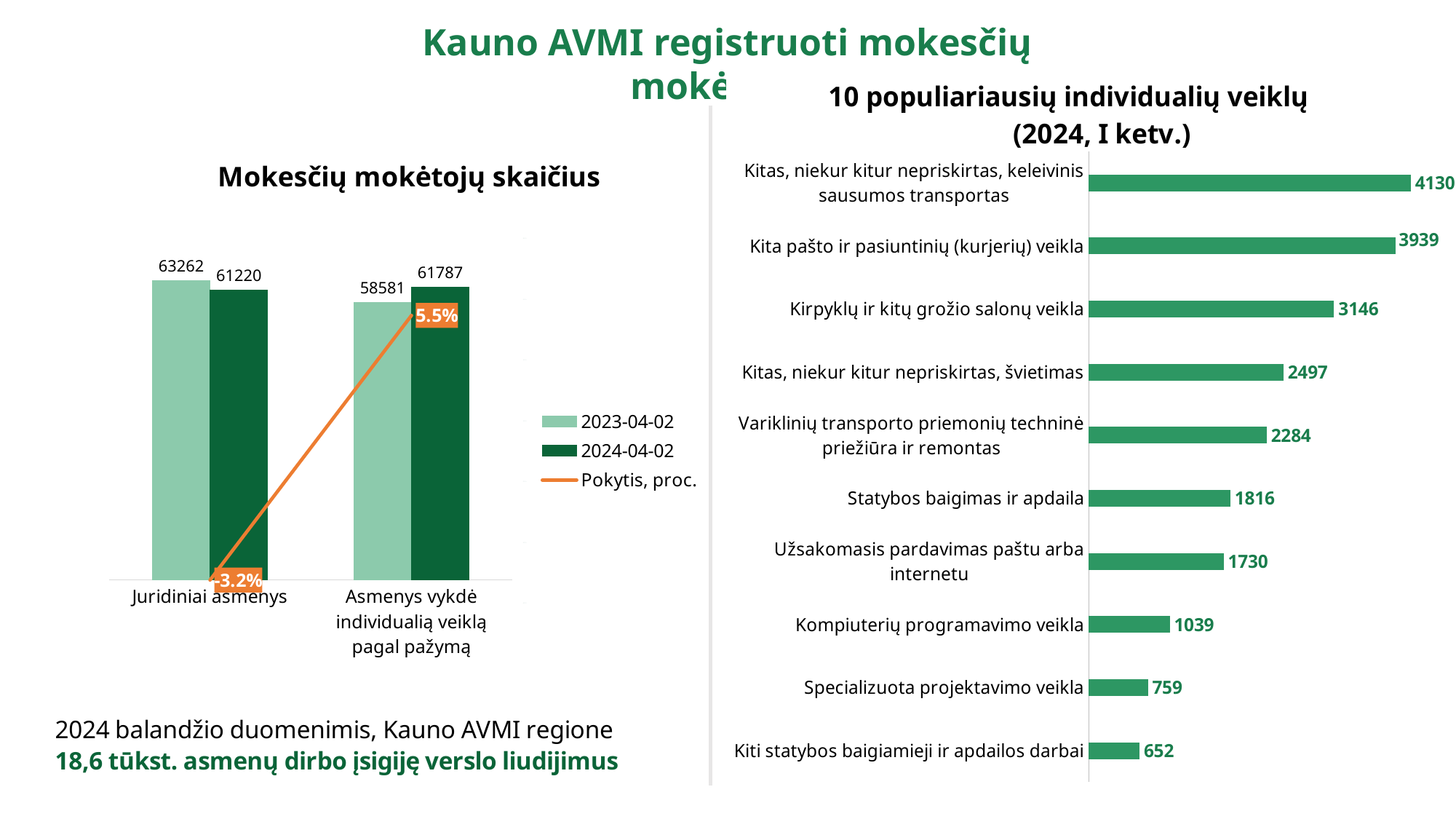
In the chart 'Mokesčių mokėtojų skaičius', what is the value for Juridiniai asmenys in the 2023-04-02 series? 63262 What kind of chart is '10 populiariausių individualių veiklų (2024, I ketv.)'? Bar chart How many categories are shown in the chart '10 populiariausių individualių veiklų (2024, I ketv.)'? 10 In the chart '10 populiariausių individualių veiklų (2024, I ketv.)', what is the difference between Statybos baigimas ir apdaila and Užsakomasis pardavimas paštu arba internetu? 86 In the chart 'Mokesčių mokėtojų skaičius', what is the Pokytis, proc. value for Juridiniai asmenys? -3.2% How many series does the legend of the chart 'Mokesčių mokėtojų skaičius' list? 3 In the chart 'Mokesčių mokėtojų skaičius', which is larger for Asmenys vykdė individualią veiklą pagal pažymą: the 2023-04-02 value or the 2024-04-02 value? 2024-04-02 In the chart 'Mokesčių mokėtojų skaičius', what is the value for Asmenys vykdė individualią veiklą pagal pažymą in the 2024-04-02 series? 61787 In the chart '10 populiariausių individualių veiklų (2024, I ketv.)', which category has the highest value? Kitas, niekur kitur nepriskirtas, keleivinis sausumos transportas In the chart '10 populiariausių individualių veiklų (2024, I ketv.)', what is the value for Kirpyklų ir kitų grožio salonų veikla? 3146 In the chart '10 populiariausių individualių veiklų (2024, I ketv.)', which category has the lowest value? Kiti statybos baigiamieji ir apdailos darbai In the chart 'Mokesčių mokėtojų skaičius', what is the difference between the 2023-04-02 and 2024-04-02 values for Juridiniai asmenys? 2042